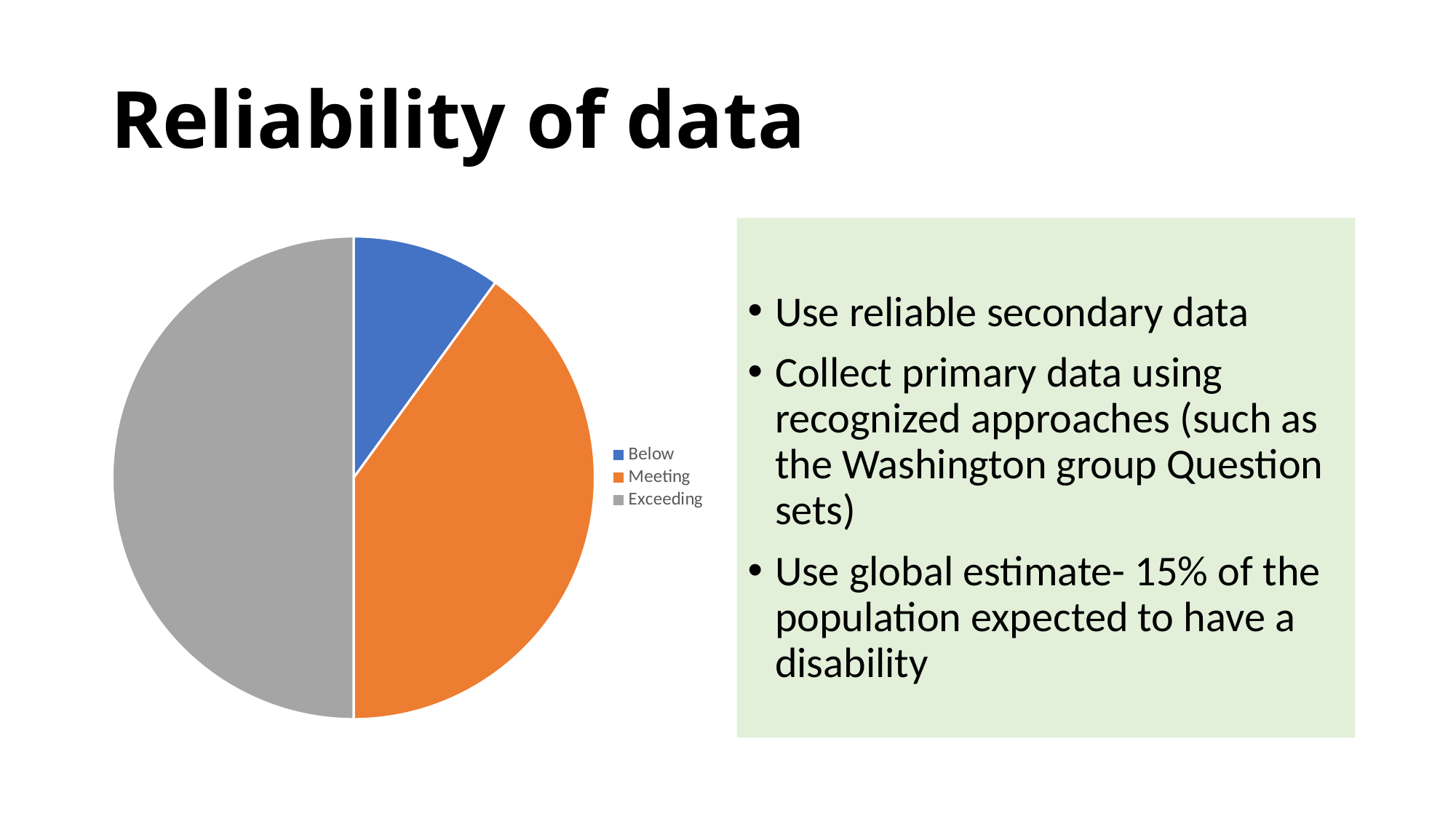
Which category has the smallest slice of the pie chart? Below What colour is the Meeting slice in the pie chart? orange How many entries does the legend of the pie chart list? 3 Which slice is smaller in the pie chart, Below or Exceeding? Below Which slice is larger in the pie chart, Exceeding or Meeting? Exceeding Which category is shown in grey in the pie chart? Exceeding What kind of chart is shown on the slide? pie chart Which category has the largest slice of the pie chart? Exceeding How many slices does the pie chart have? 3 Which slice is larger in the pie chart, Meeting or Below? Meeting